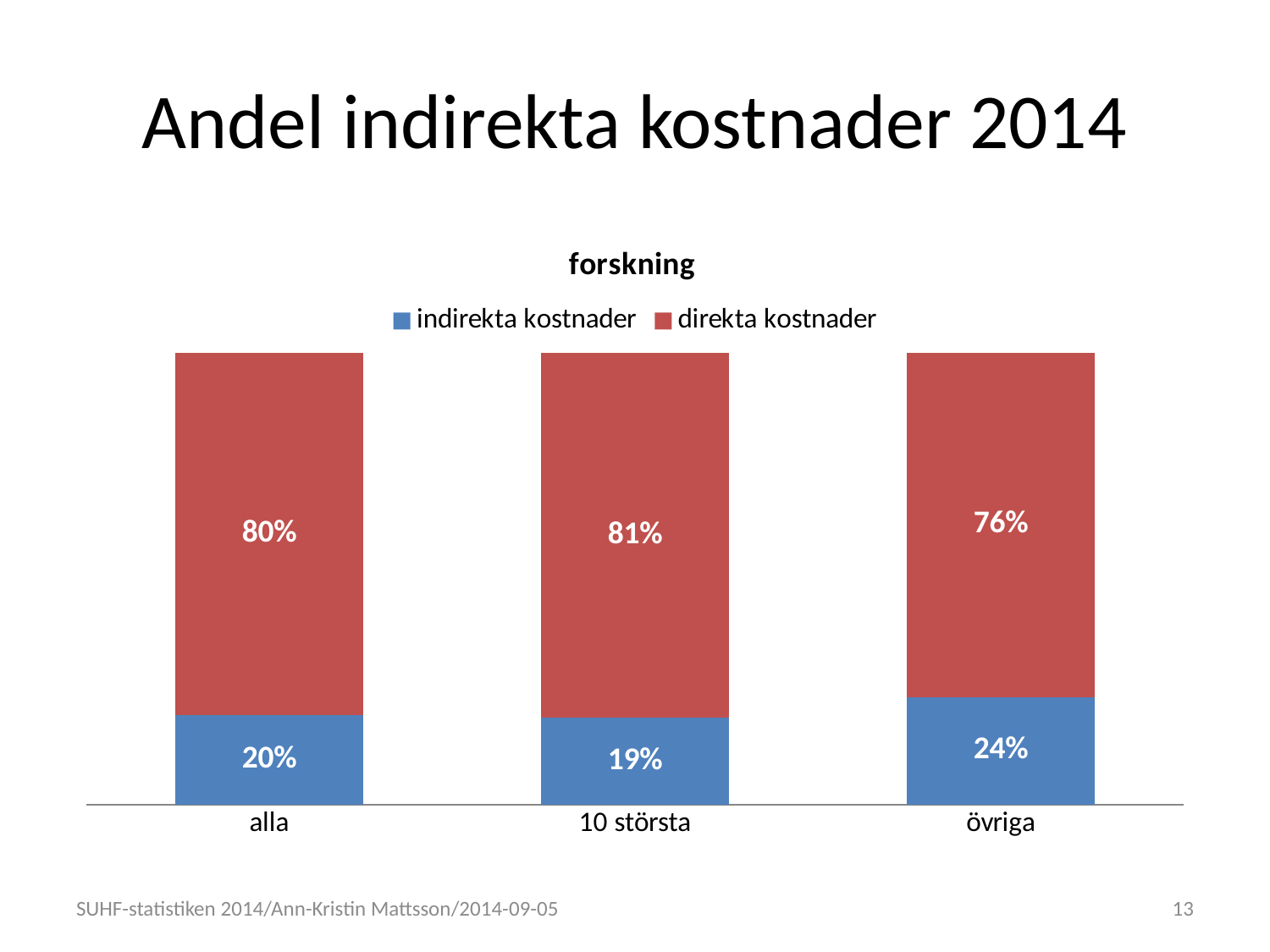
How many categories are shown on the x axis? 3 Is the direkta kostnader share larger for 10 största or for övriga? 10 största What is the value of indirekta kostnader for alla? 20% Which category has the lowest share of indirekta kostnader? 10 största What kind of chart is shown? stacked bar chart What is the value of direkta kostnader for övriga? 76% What is the difference between the indirekta kostnader share for övriga and for alla? 4% What is the value of direkta kostnader for 10 största? 81% Which category has the highest share of indirekta kostnader? övriga What is the value of indirekta kostnader for övriga? 24% What is the title of the chart? forskning How many series does the legend list? 2